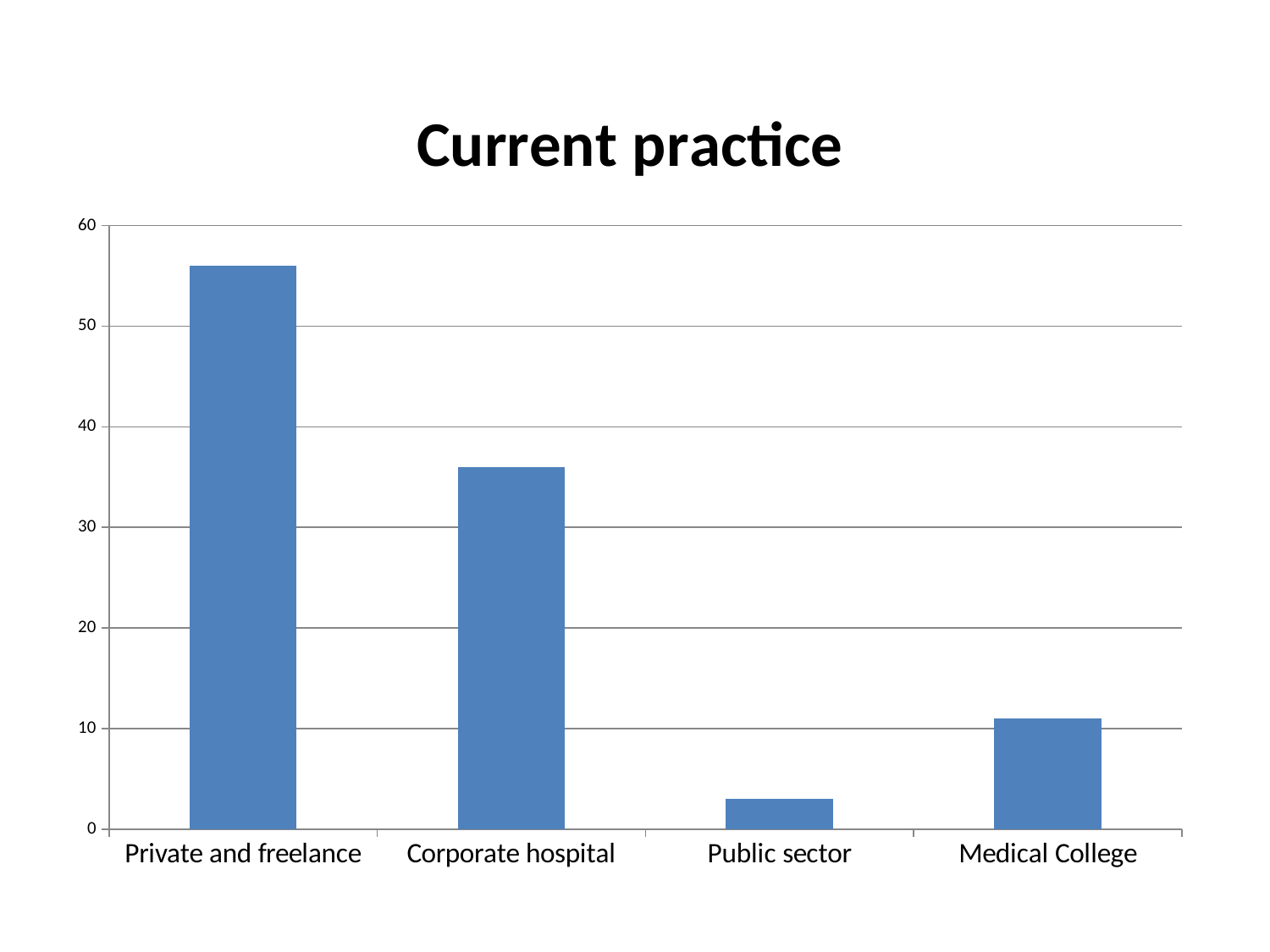
Which category has the lowest value? Public sector What kind of chart is shown on the slide? bar chart Is the value for Public sector greater or less than 10? less Is the value for Medical College greater or less than 10? greater How many categories are shown on the x axis? 4 What is the maximum value shown on the y axis? 60 Is the value for Corporate hospital greater or less than 40? less Which is larger, the value for Corporate hospital or the value for Medical College? Corporate hospital What is the title of the chart? Current practice Which category has the highest value? Private and freelance Which is larger, the value for Public sector or the value for Medical College? Medical College